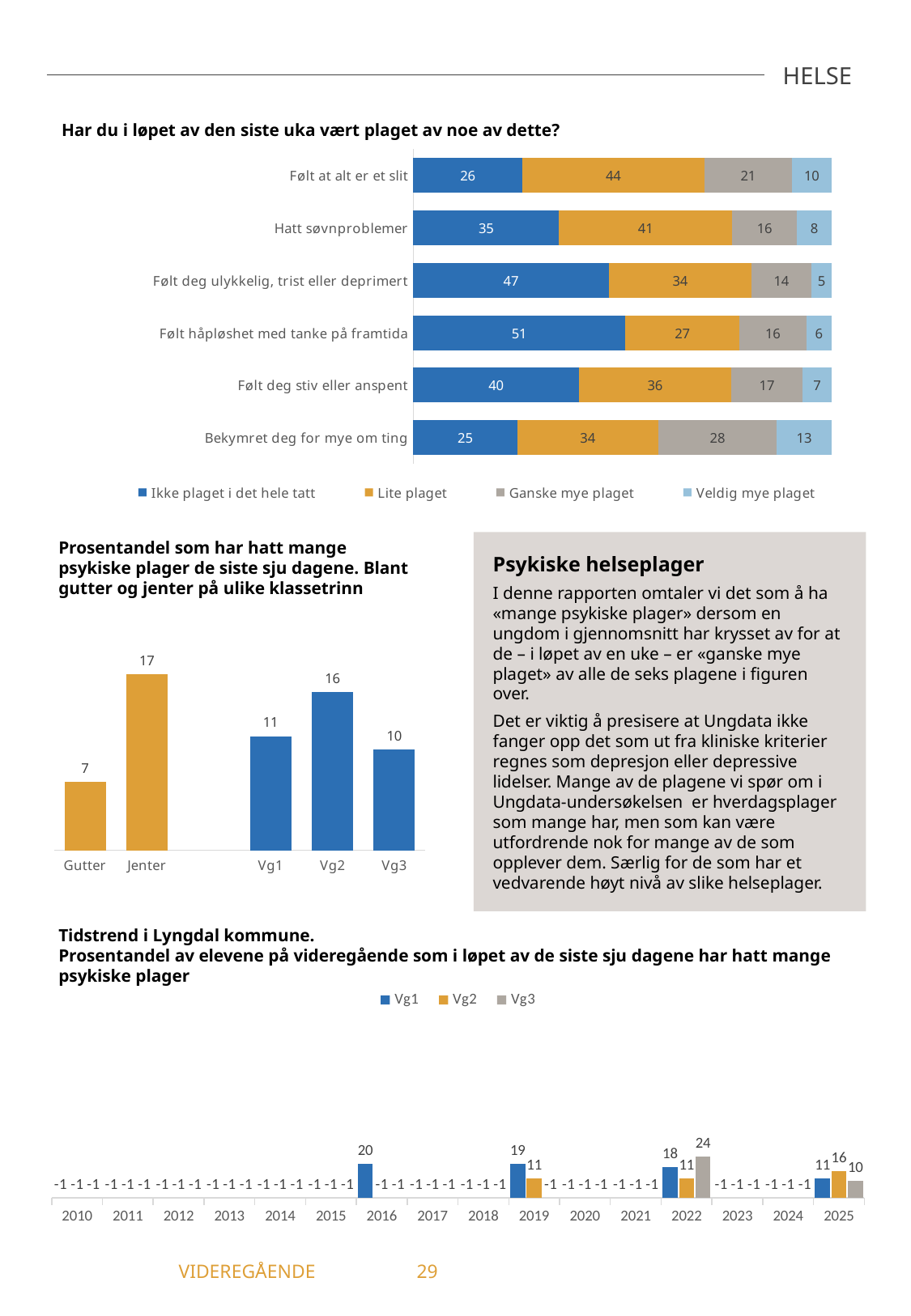
In the top chart 'Har du i løpet av den siste uka vært plaget av noe av dette?', how many series does the legend list? 4 In the bottom chart 'Tidstrend i Lyngdal kommune', which is larger in 2025: Vg1 or Vg2? Vg2 In the top chart 'Har du i løpet av den siste uka vært plaget av noe av dette?', what is the difference between the 'Ganske mye plaget' values for 'Bekymret deg for mye om ting' and 'Følt deg ulykkelig, trist eller deprimert'? 14 In the middle-left chart 'Prosentandel som har hatt mange psykiske plager de siste sju dagene', what is the value for Jenter? 17 In the bottom chart 'Tidstrend i Lyngdal kommune', what is the value for Vg3 in 2022? 24 In the top chart 'Har du i løpet av den siste uka vært plaget av noe av dette?', which category has the highest value for 'Ikke plaget i det hele tatt'? Følt håpløshet med tanke på framtida In the middle-left chart 'Prosentandel som har hatt mange psykiske plager de siste sju dagene', which category has the lowest value? Gutter In the top chart 'Har du i løpet av den siste uka vært plaget av noe av dette?', what is the value for 'Veldig mye plaget' for 'Bekymret deg for mye om ting'? 13 What kind of chart is the bottom chart 'Tidstrend i Lyngdal kommune'? Bar chart In the top chart 'Har du i løpet av den siste uka vært plaget av noe av dette?', what is the value for 'Lite plaget' for 'Følt at alt er et slit'? 44 In the middle-left chart 'Prosentandel som har hatt mange psykiske plager de siste sju dagene', what is the difference between Vg2 and Vg3? 6 In the top chart 'Har du i løpet av den siste uka vært plaget av noe av dette?', how many categories are shown? 6